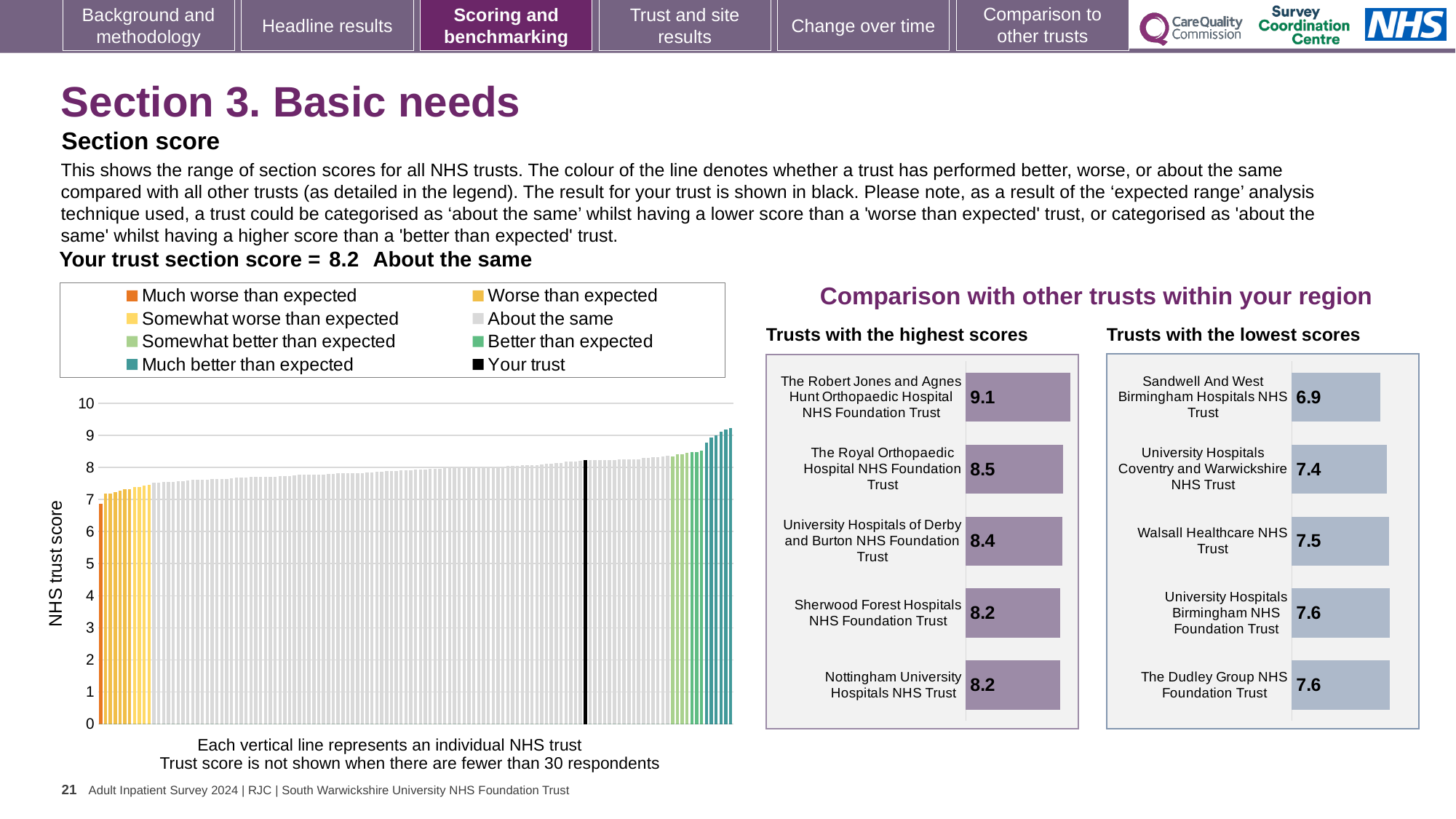
In the 'Trusts with the lowest scores' chart, which trust has the lowest score? Sandwell And West Birmingham Hospitals NHS Trust In the 'Trusts with the lowest scores' chart, what is the score for Walsall Healthcare NHS Trust? 7.5 In the large chart on the left, how many entries does the legend list? 8 In the large chart on the left, do the trust scores rise or fall from left to right? rise In the large chart on the left, what is the label on the vertical axis? NHS trust score In the large chart on the left, is the value of the tallest bar greater or less than 9? greater In the 'Trusts with the highest scores' chart, what is the difference between the scores of The Robert Jones and Agnes Hunt Orthopaedic Hospital NHS Foundation Trust and The Royal Orthopaedic Hospital NHS Foundation Trust? 0.6 In the 'Trusts with the highest scores' chart, how many trusts are shown? 5 In the 'Trusts with the lowest scores' chart, which has the larger score: Walsall Healthcare NHS Trust or University Hospitals Coventry and Warwickshire NHS Trust? Walsall Healthcare NHS Trust What kind of chart is the large chart on the left showing the range of section scores for all NHS trusts? bar chart In the 'Trusts with the highest scores' chart, what is the score for The Robert Jones and Agnes Hunt Orthopaedic Hospital NHS Foundation Trust? 9.1 In the 'Trusts with the highest scores' chart, which trust has the highest score? The Robert Jones and Agnes Hunt Orthopaedic Hospital NHS Foundation Trust